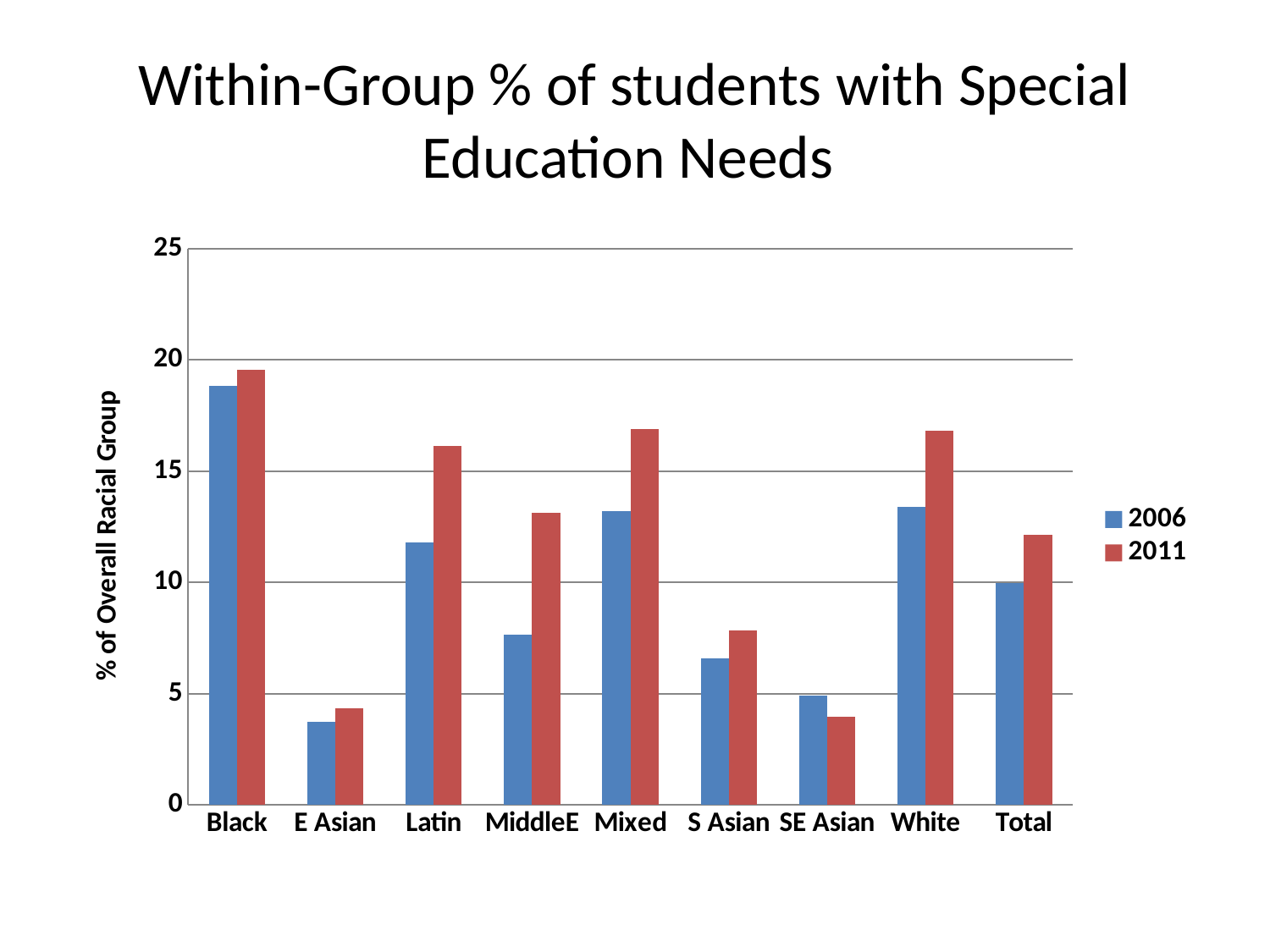
Is the 2006 value for Black greater or less than 15? greater For SE Asian, which year has the larger value, 2006 or 2011? 2006 Is the 2011 value for E Asian greater or less than 5? less What kind of chart is shown on the slide? bar chart Which category has the highest value for 2006? Black Which category has the highest value for 2011? Black How many racial group categories are shown on the x axis? 9 What is the label of the y axis? % of Overall Racial Group Is the 2006 value for MiddleE greater or less than 10? less Which category has the lowest value for 2006? E Asian How many series does the legend list? 2